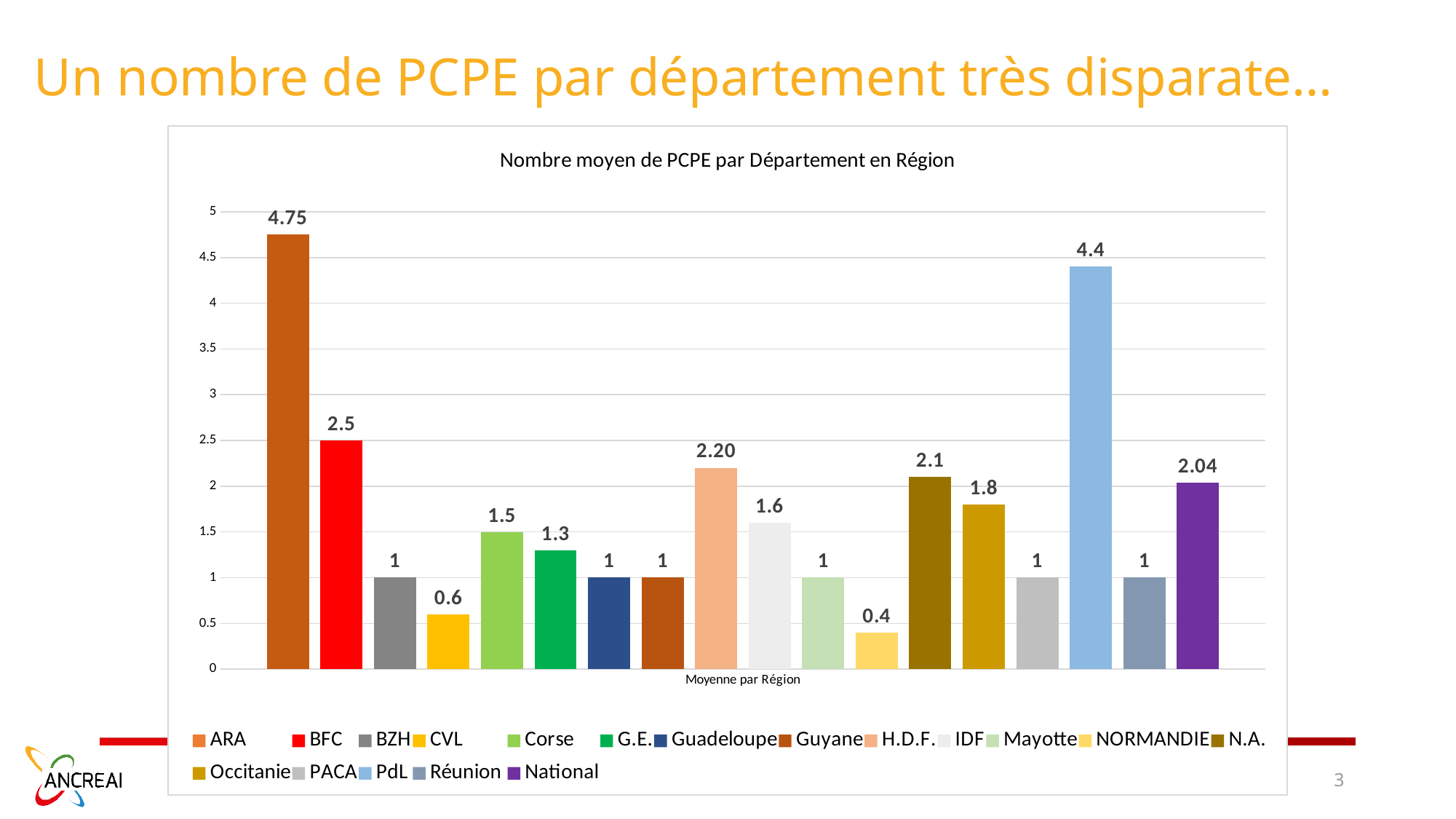
What is the value for H.D.F.? 2.20 What is the value for ARA? 4.75 What is the title of the chart? Nombre moyen de PCPE par Département en Région Which is larger, the value for BFC or the value for N.A.? BFC What kind of chart is shown on the slide? bar chart Which region has the highest value? ARA Is the value for Occitanie greater or less than 2? less What is the value for National? 2.04 Which region has the lowest value? NORMANDIE How many series does the legend list? 18 What is the value for PdL? 4.4 What is the difference between the values for ARA and PdL? 0.35